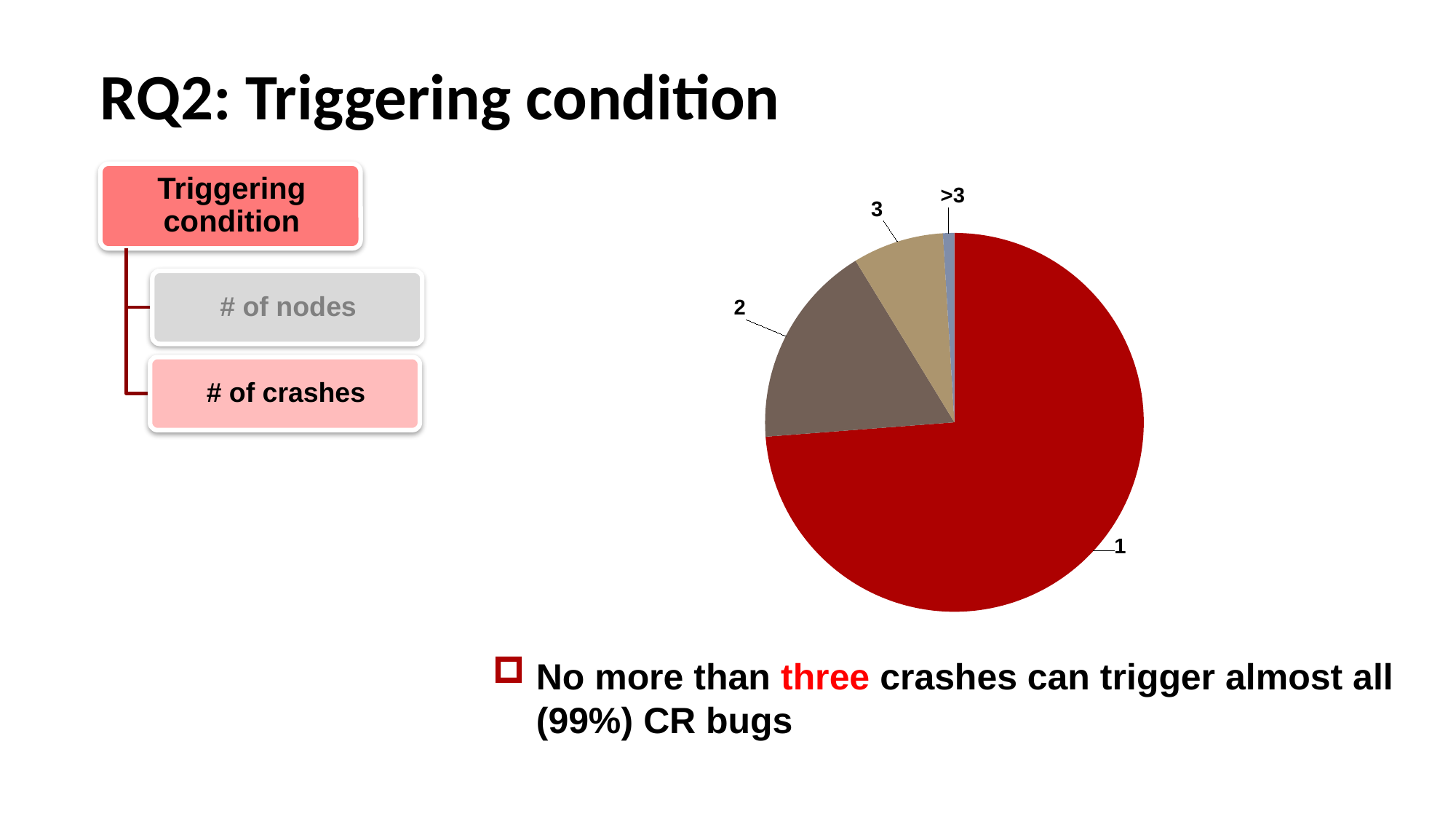
What kind of chart is shown on the slide? pie chart What are the labels of the slices in the pie chart? 1, 2, 3, >3 Which slice is larger in the pie chart, 2 or 3? 2 Which slice is larger in the pie chart, 3 or >3? 3 What colour is the slice labelled 1 in the pie chart? dark red How many slices does the pie chart have? 4 Which slice is larger in the pie chart, 1 or 2? 1 Which category has the largest slice in the pie chart? 1 Which category has the smallest slice in the pie chart? >3